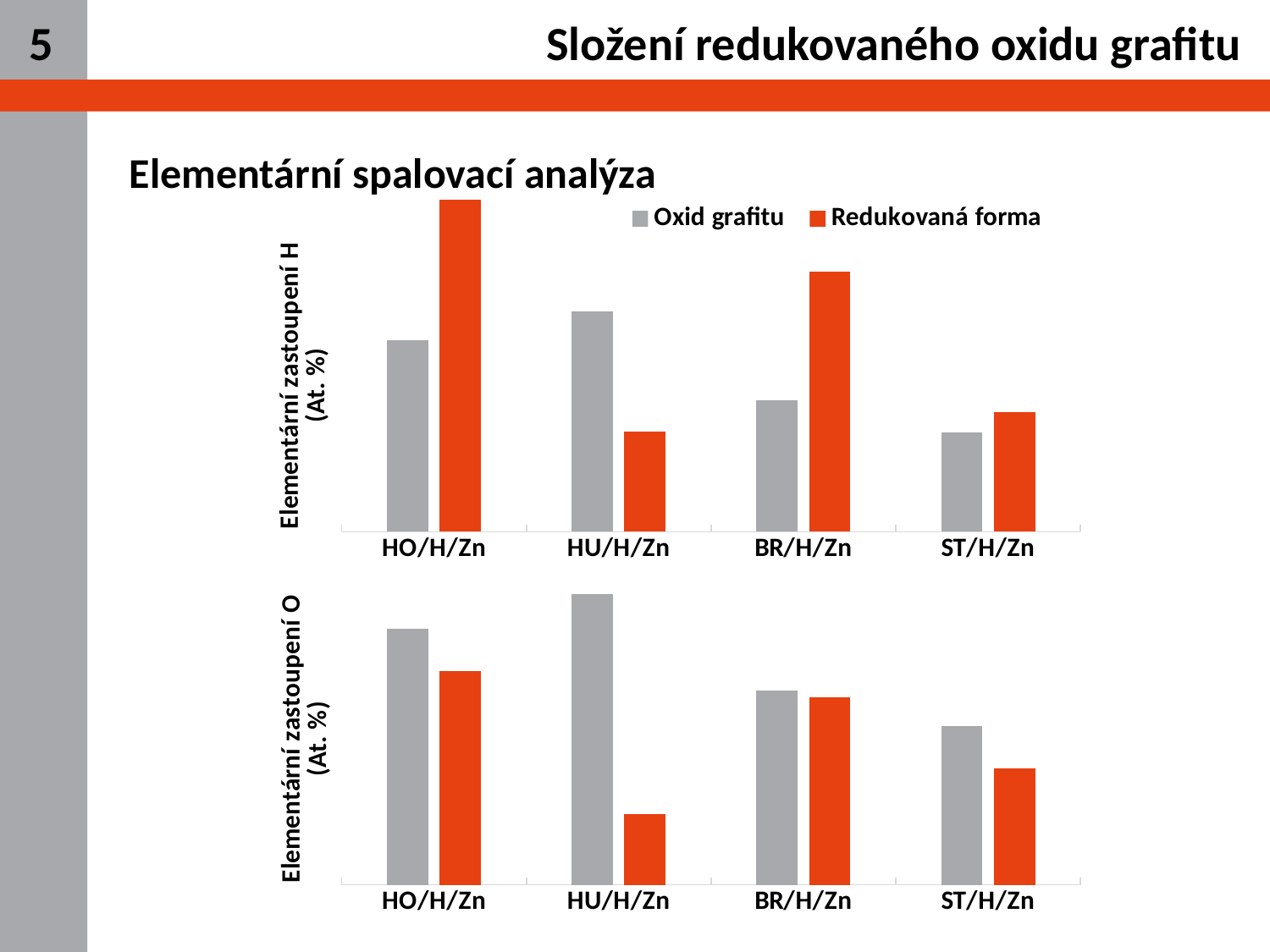
How many categories are shown on the x axis of the bottom chart (Elementární zastoupení O)? 4 In the bottom chart (Elementární zastoupení O), for ST/H/Zn, which is larger: Oxid grafitu or Redukovaná forma? Oxid grafitu In the top chart (Elementární zastoupení H), which category has the highest Oxid grafitu value? HU/H/Zn In the bottom chart (Elementární zastoupení O), which category has the lowest Redukovaná forma value? HU/H/Zn In the top chart (Elementární zastoupení H), which category has the highest Redukovaná forma value? HO/H/Zn In the bottom chart (Elementární zastoupení O), which category has the highest Oxid grafitu value? HU/H/Zn In the top chart (Elementární zastoupení H), for HU/H/Zn, which is larger: Oxid grafitu or Redukovaná forma? Oxid grafitu What are the two legend entries shown on the top chart? Oxid grafitu and Redukovaná forma What kind of chart is the top chart (Elementární zastoupení H)? bar chart How many series does the legend of the top chart list? 2 In the top chart (Elementární zastoupení H), for BR/H/Zn, which is larger: Oxid grafitu or Redukovaná forma? Redukovaná forma In the top chart (Elementární zastoupení H), which category has the lowest Oxid grafitu value? ST/H/Zn